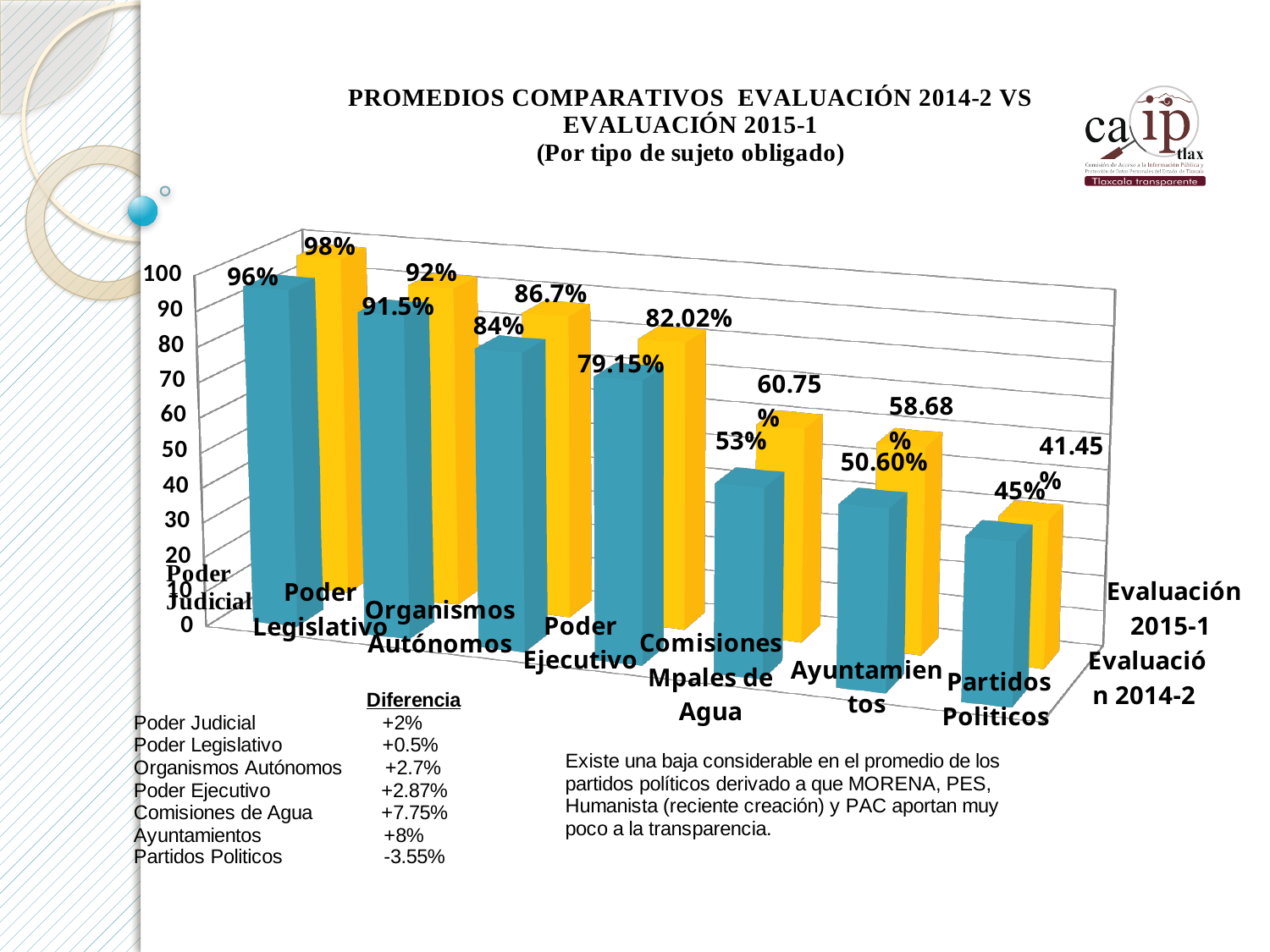
What kind of chart is shown on the slide? Bar chart How many series does the chart show? 2 What is the difference between the Evaluación 2015-1 and Evaluación 2014-2 values for Ayuntamientos? 8.08% What is the Evaluación 2015-1 value for Comisiones Mpales de Agua? 60.75% What is the Evaluación 2014-2 value for Poder Judicial? 96% Do the Evaluación 2015-1 values rise or fall moving from Poder Judicial to Partidos Politicos? Fall Which category has the lowest Evaluación 2014-2 value? Partidos Politicos How many categories (tipos de sujeto obligado) are shown on the chart? 7 What is the Evaluación 2015-1 value for Poder Ejecutivo? 82.02% Which category has the highest Evaluación 2015-1 value? Poder Judicial For Partidos Politicos, which is larger: the Evaluación 2014-2 value or the Evaluación 2015-1 value? Evaluación 2014-2 What is the Evaluación 2014-2 value for Ayuntamientos? 50.60%